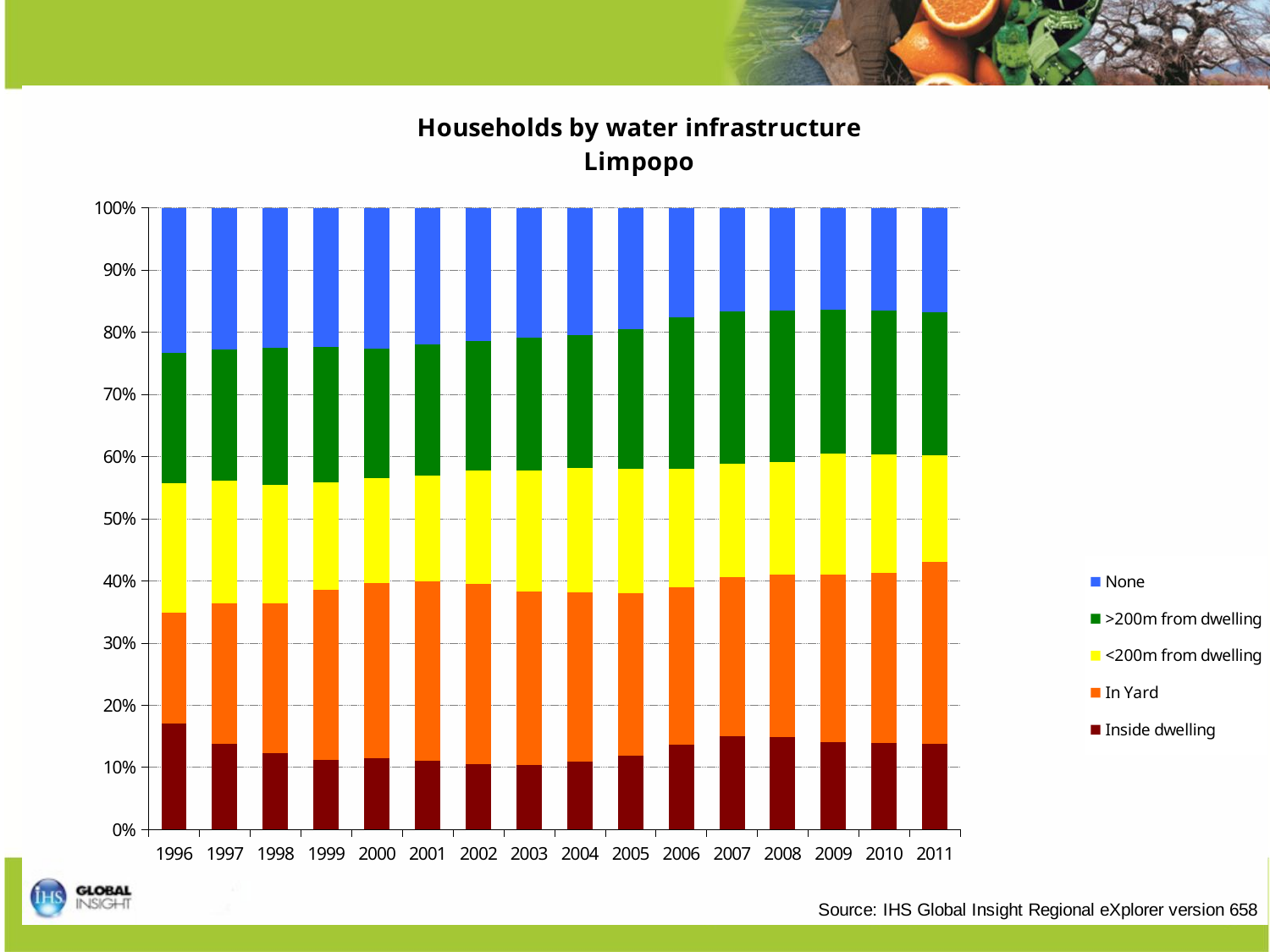
What is the total of each stacked bar in the chart? 100% Which is larger, the Inside dwelling share in 1996 or in 2002? 1996 How many years are shown along the x axis of the chart? 16 Is the Inside dwelling share for 1996 greater or less than 20%? less Is the In Yard share for 2011 greater or less than 20%? greater What kind of chart is shown on the slide? Stacked bar chart Which series is shown in blue in the legend? None Does the None share rise or fall from 1996 to 2011? Fall Is the Inside dwelling share for 1996 greater or less than 10%? greater How many series does the legend list? 5 What is the title of the chart? Households by water infrastructure Limpopo